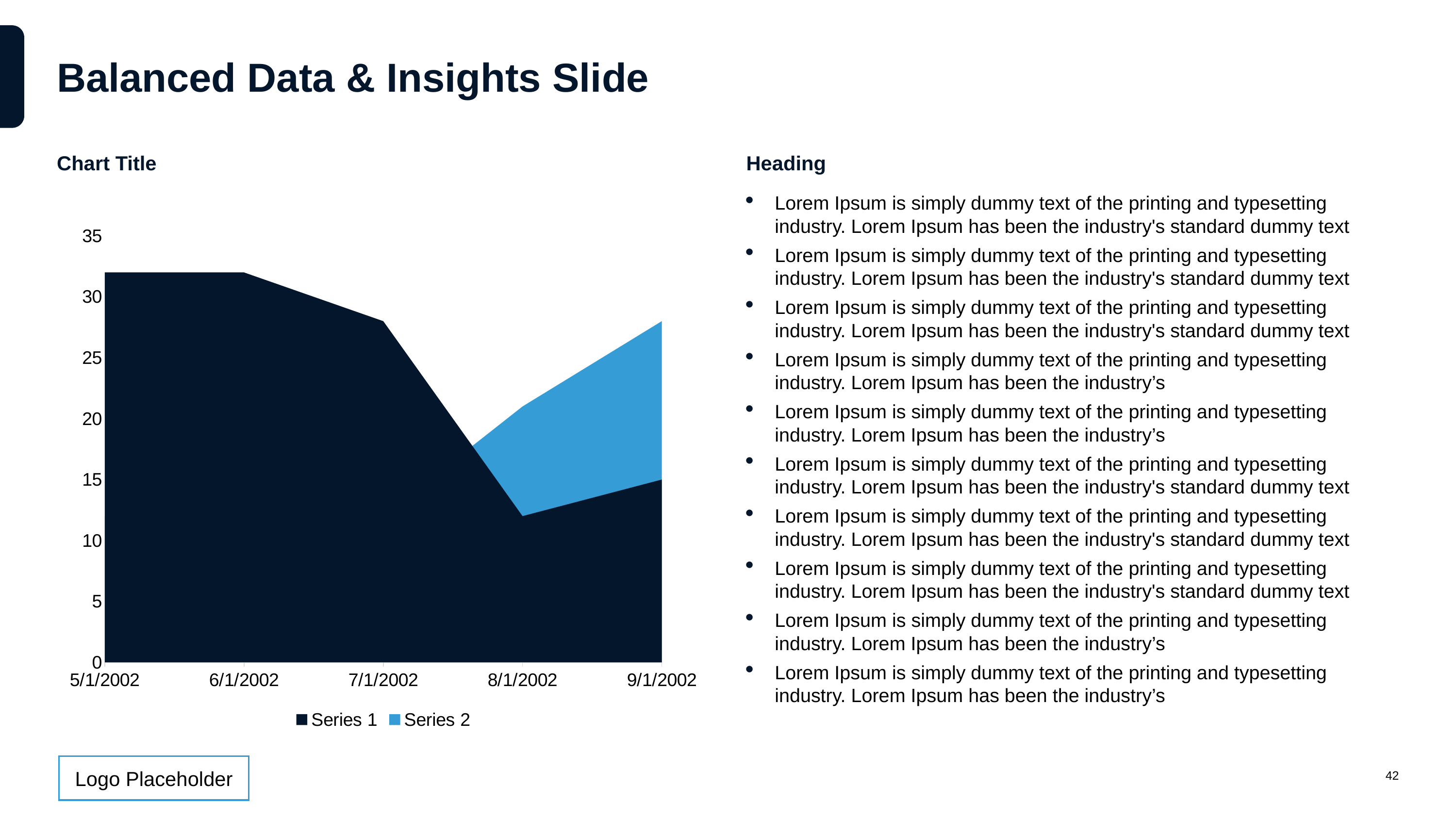
Is the value for Series 1 at 8/1/2002 greater or less than 15? less How many series does the chart legend list? 2 What kind of chart is shown on the slide? Area chart What is the title of the chart? Chart Title Is the value for Series 2 at 9/1/2002 greater or less than 25? greater Is the value for Series 1 at 9/1/2002 greater or less than 20? less Does Series 1 rise or fall from 6/1/2002 to 8/1/2002? Fall How many dates are shown on the x axis of the chart? 5 At 9/1/2002, which series has the larger value, Series 1 or Series 2? Series 2 At which date does Series 1 reach its lowest value? 8/1/2002